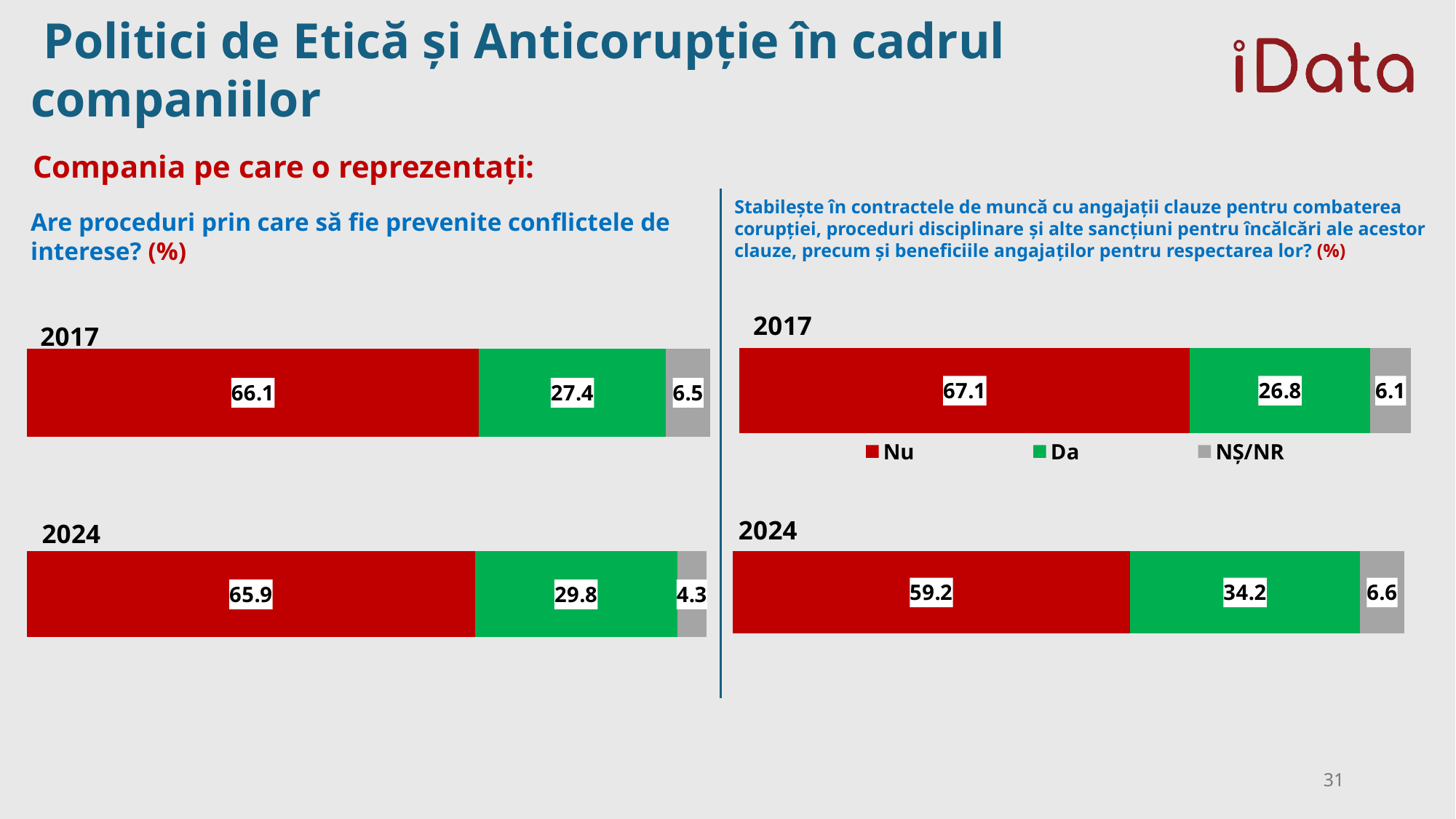
In the right chart, does the Da value rise or fall from 2017 to 2024? Rise In the right chart, which is larger: the Nu value in 2017 or the Nu value in 2024? 2017 In the right chart, what is the difference between the Da values for 2024 and 2017? 7.4 What kind of chart is used on the left side of the slide? Stacked bar chart In the left chart, what is the value for Da in 2024? 29.8 In the right chart, what is the value for NȘ/NR in 2017? 6.1 In the left chart, what is the value for Nu in 2017? 66.1 In the left chart, which segment is the largest in the 2024 bar? Nu In the left chart, what is the difference between the NȘ/NR values for 2017 and 2024? 2.2 In the right chart, what is the value for Nu in 2024? 59.2 How many series does the legend on the right chart list? 3 In the right chart, which segment is the smallest in the 2024 bar? NȘ/NR